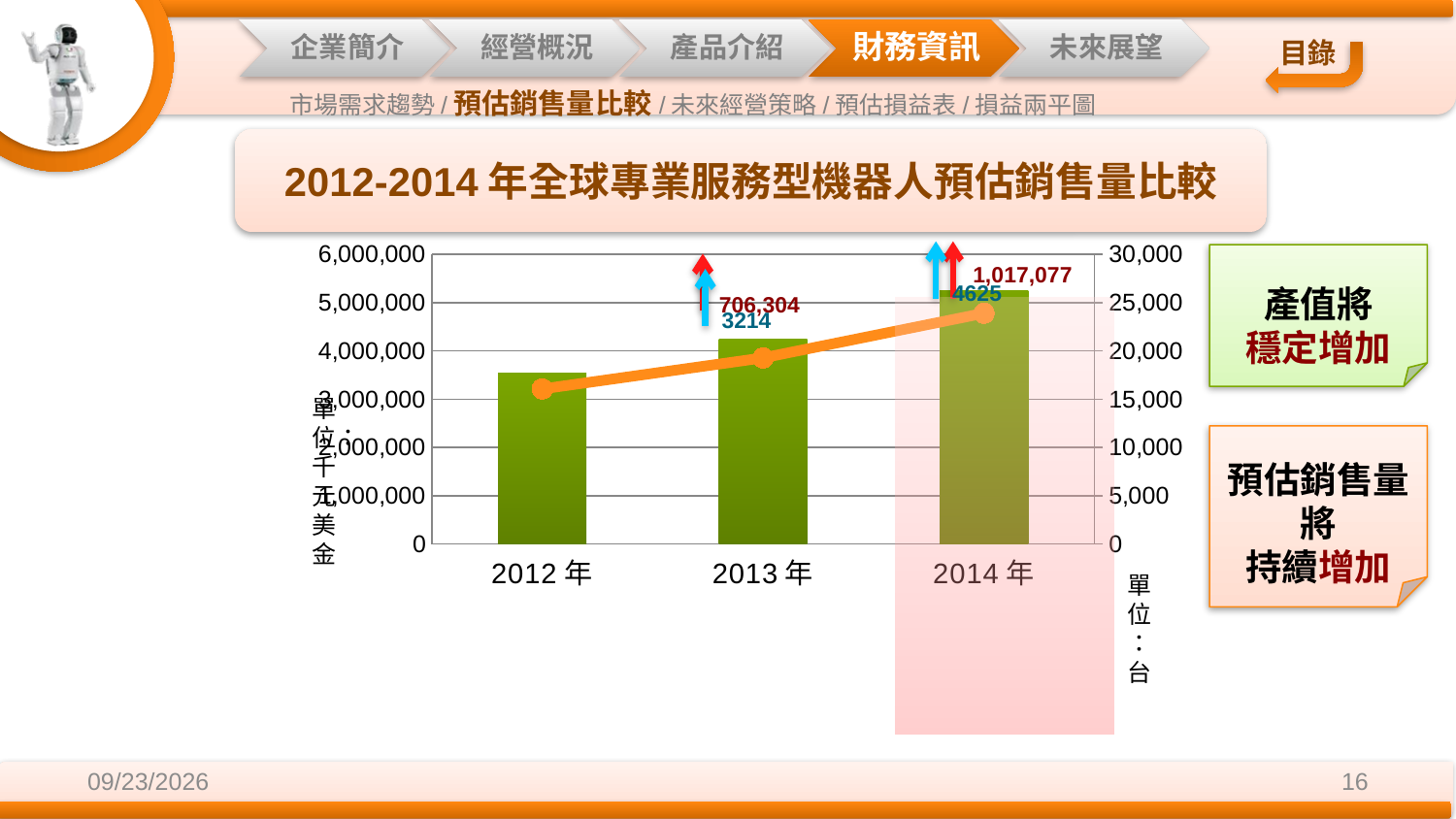
What is the title of the chart? 2012-2014 年全球專業服務型機器人預估銷售量比較 Do the bar values rise or fall from 2012 年 to 2014 年? rise Which year has the tallest bar? 2014 年 Which year has the shortest bar? 2012 年 How many years (categories) are plotted on the x axis? 3 What is the highest tick value shown on the right-hand axis? 30,000 Is the line value for 2014 年 greater or less than 25,000 on the right axis? less Is the bar value for 2012 年 greater or less than 3,000,000 on the left axis? greater Is the bar value for 2013 年 greater or less than 4,000,000 on the left axis? greater Which year has the larger bar, 2012 年 or 2013 年? 2013 年 What kind of chart is shown on the slide? bar chart with a line